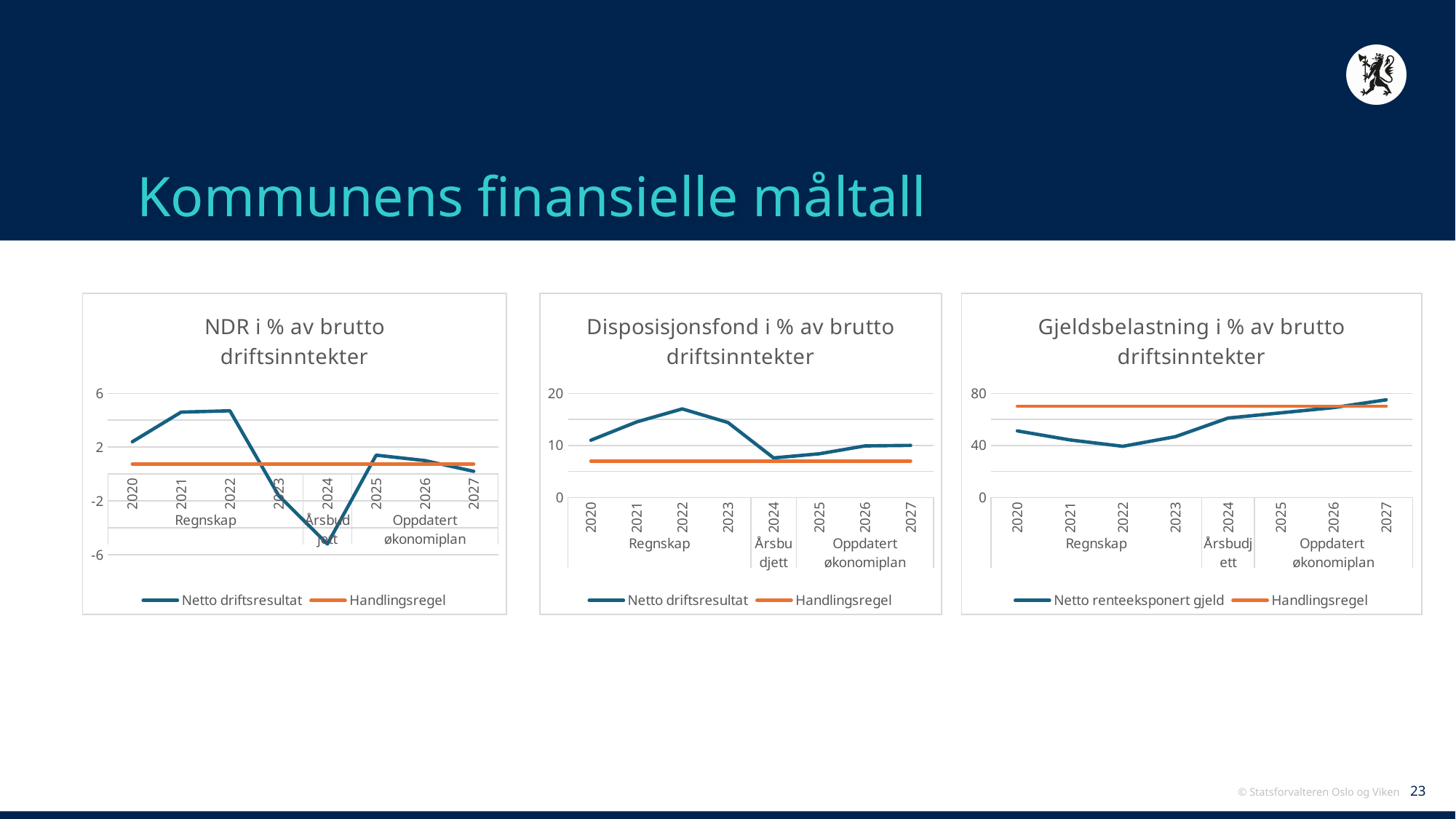
In the "Gjeldsbelastning i % av brutto driftsinntekter" chart, what are the two series named in the legend? Netto renteeksponert gjeld and Handlingsregel In the "Disposisjonsfond i % av brutto driftsinntekter" chart, which year has the highest Netto driftsresultat? 2022 In the "NDR i % av brutto driftsinntekter" chart, is the Netto driftsresultat value for 2024 greater or less than -2? less In the "NDR i % av brutto driftsinntekter" chart, which year has the lowest Netto driftsresultat? 2024 In the "Gjeldsbelastning i % av brutto driftsinntekter" chart, which year has the highest Netto renteeksponert gjeld? 2027 In the "Disposisjonsfond i % av brutto driftsinntekter" chart, how many years are plotted on the x axis? 8 In the "Disposisjonsfond i % av brutto driftsinntekter" chart, is the Netto driftsresultat value for 2024 greater or less than 10? less In the "Gjeldsbelastning i % av brutto driftsinntekter" chart, is the Netto renteeksponert gjeld value for 2027 greater or less than 40? greater What kind of chart is "NDR i % av brutto driftsinntekter"? Line chart In the "NDR i % av brutto driftsinntekter" chart, how many series does the legend list? 2 In the "Gjeldsbelastning i % av brutto driftsinntekter" chart, does the Netto renteeksponert gjeld line rise or fall from 2022 to 2027? rise In the "Disposisjonsfond i % av brutto driftsinntekter" chart, does the Netto driftsresultat line rise or fall from 2020 to 2022? rise